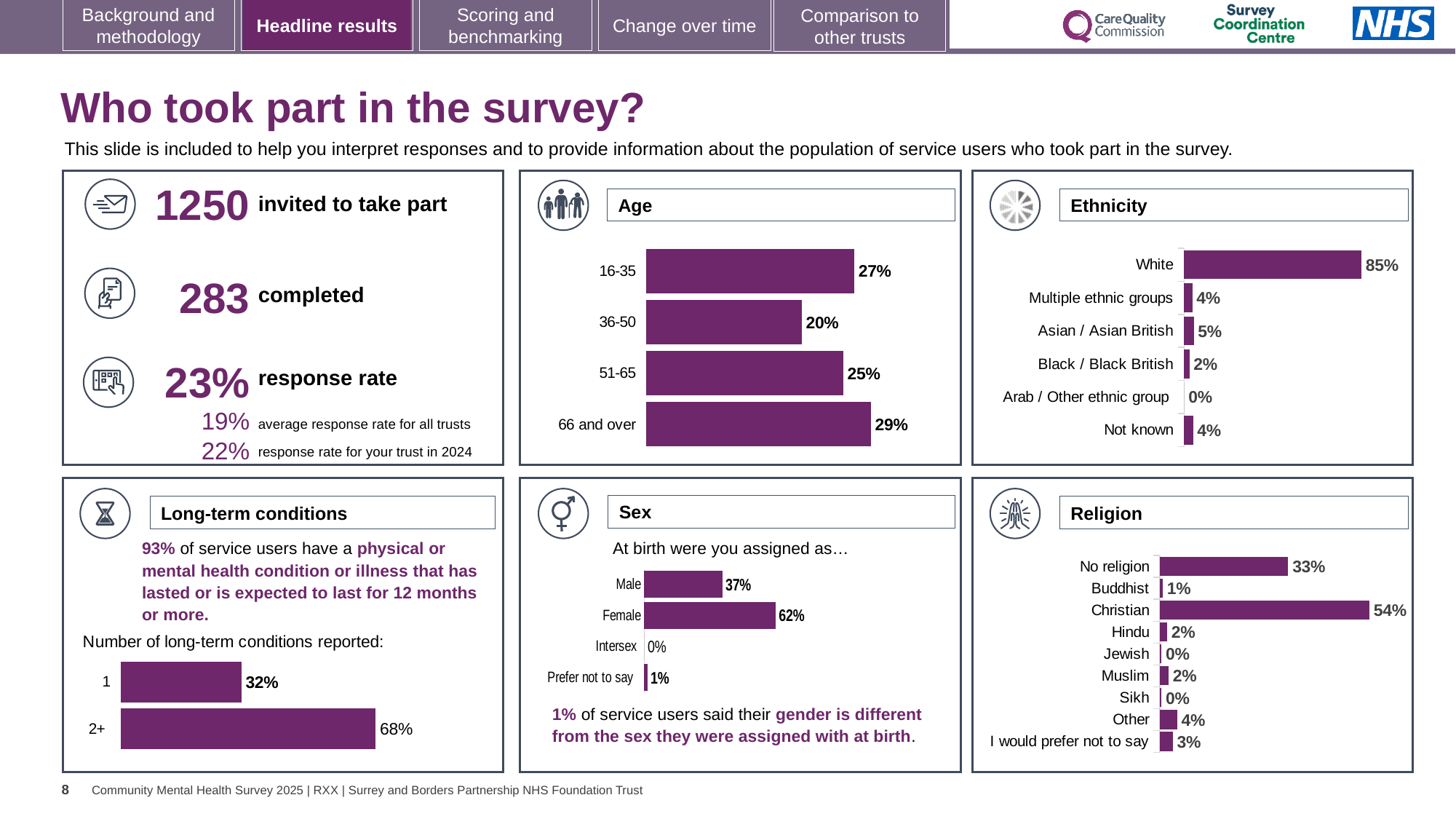
In the Ethnicity chart, what percentage of respondents were White? 85% In the Long-term conditions chart, what percentage of service users reported 2+ long-term conditions? 68% In the Age chart, what percentage of respondents were aged 66 and over? 29% In the Religion chart, what is the difference between Christian and No religion? 21% What type of chart is used in the Age panel? Bar chart In the Age chart, how many age categories are shown? 4 In the Sex chart, which is larger, Male or Female? Female In the Age chart, which age group has the lowest percentage? 36-50 In the Ethnicity chart, what is the difference between the White and Asian / Asian British percentages? 80% In the Ethnicity chart, how many ethnicity categories are listed? 6 In the Sex chart, what percentage of respondents were assigned Female at birth? 62% In the Religion chart, which religion category has the highest percentage? Christian